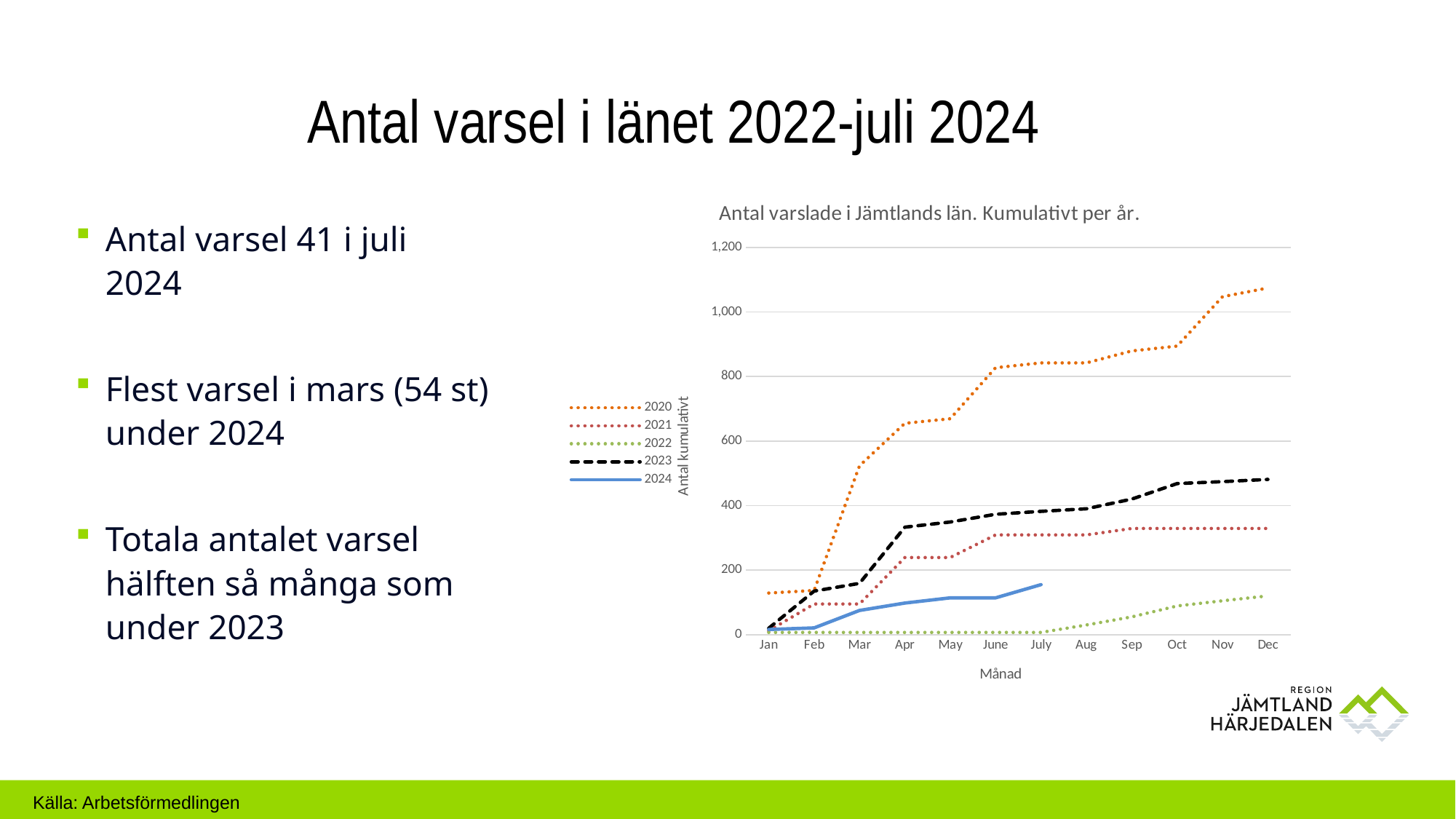
Is the value for 2024 in July greater or less than 200? less Which year's line has the lowest values across the chart? 2022 Is the value for 2022 in December greater or less than 200? less What kind of chart is shown on the slide? line chart Do the lines in the chart rise or fall from January to December? rise Is the value for 2020 in December greater or less than 1,000? greater How many series does the legend of the chart list? 5 Which year's line reaches the highest value in December? 2020 What is the title of the chart? Antal varslade i Jämtlands län. Kumulativt per år. How many months are shown on the x axis of the chart? 12 In July, which is larger: the value for 2023 or the value for 2024? 2023